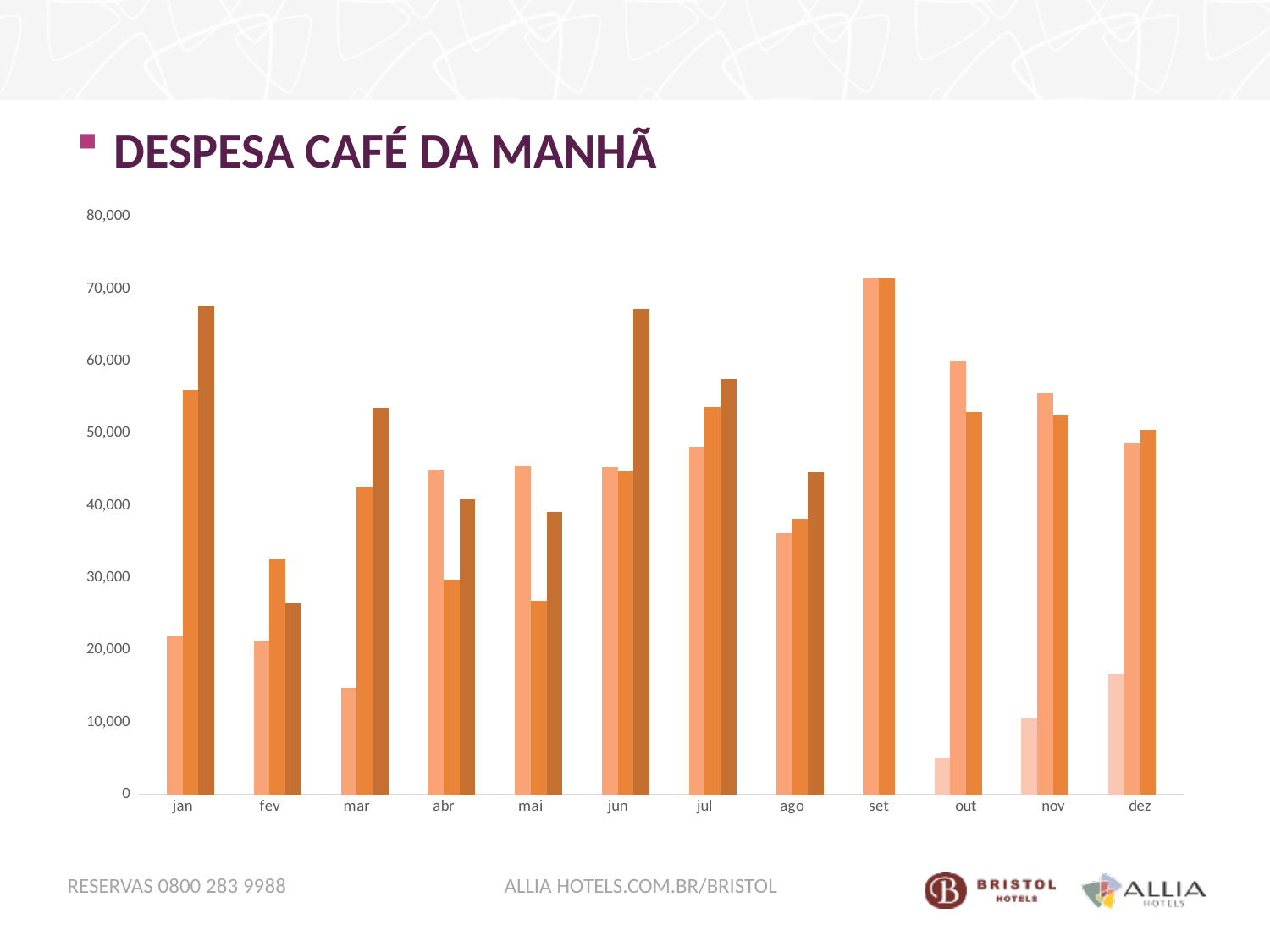
Which month has the tallest bar in the chart? set How many months are shown on the x axis of the chart? 12 Is the tallest bar for set greater or less than 70,000? greater Which month has the shortest bar in the chart? out Is the tallest bar for ago greater or less than 50,000? less Is the shortest bar for mar greater or less than 20,000? less Which month has a taller tallest bar, jun or abr? jun What kind of chart is shown on the slide? bar chart What is the title of the chart? DESPESA CAFÉ DA MANHÃ Which month has a taller tallest bar, jan or fev? jan